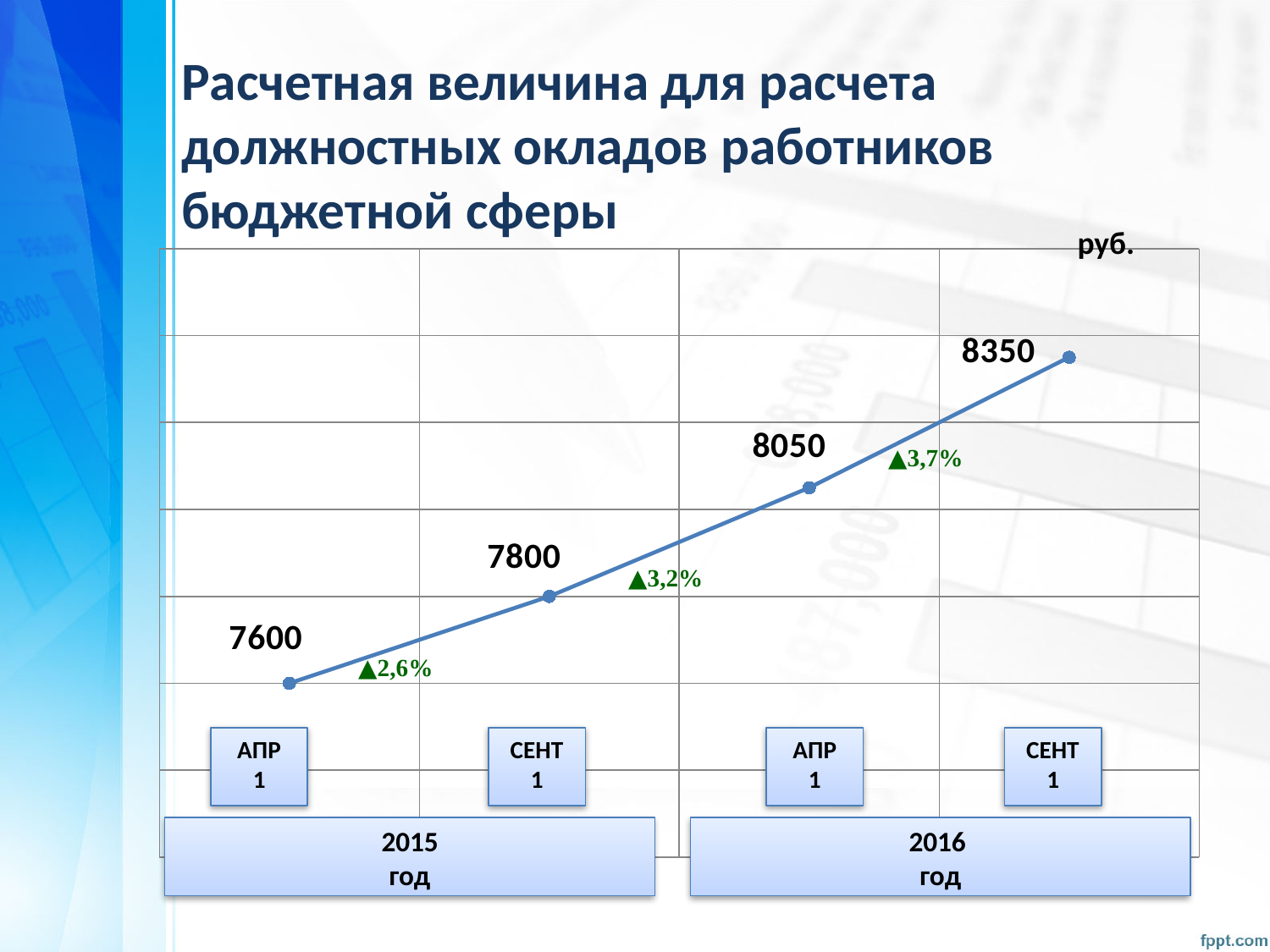
What is the difference between the value for 1 September 2016 and the value for 1 April 2015? 750 What is the value for 1 September 2015 (СЕНТ 1, 2015 год)? 7800 Which point has the lowest value? АПР 1, 2015 год How many data points are plotted on the line? 4 What is the difference between the value for 1 April 2016 and the value for 1 September 2015? 250 What is the value for 1 April 2015 (АПР 1, 2015 год)? 7600 What type of chart is shown on the slide? line chart What is the value for 1 April 2016 (АПР 1, 2016 год)? 8050 Do the values rise or fall from left to right along the x axis? rise Which point has the highest value? СЕНТ 1, 2016 год What is the value for 1 September 2016 (СЕНТ 1, 2016 год)? 8350 What percentage increase is labelled between 1 September 2015 and 1 April 2016? 3,2%